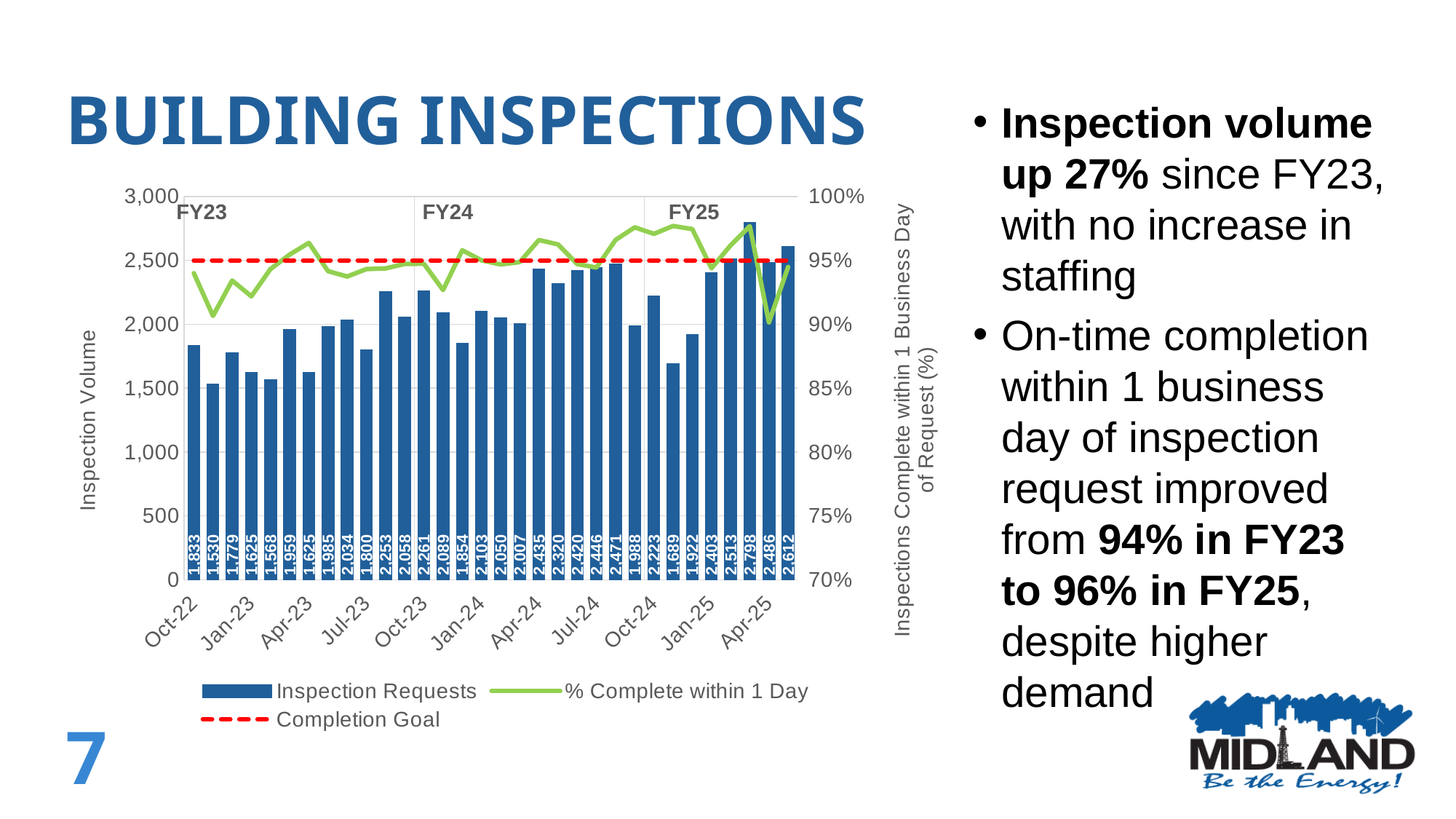
Is the % Complete within 1 Day value for Apr-25 greater or less than 95%? less What is the value of Inspection Requests for Oct-22? 1,833 What is the highest Inspection Requests value shown on the chart? 2,798 At what percentage is the Completion Goal line drawn? 95% What is the value of Inspection Requests for Apr-24? 2,435 Do Inspection Requests generally rise or fall from Oct-22 to Apr-25? Rise What kind of chart is used to show Inspection Requests? Bar chart Which month has more Inspection Requests, Jan-24 or Jan-25? Jan-25 How many monthly bars are plotted on the chart? 32 What is the difference in Inspection Requests between Oct-24 and Oct-22? 390 How many series does the legend list? 3 What is the lowest Inspection Requests value shown on the chart? 1,530